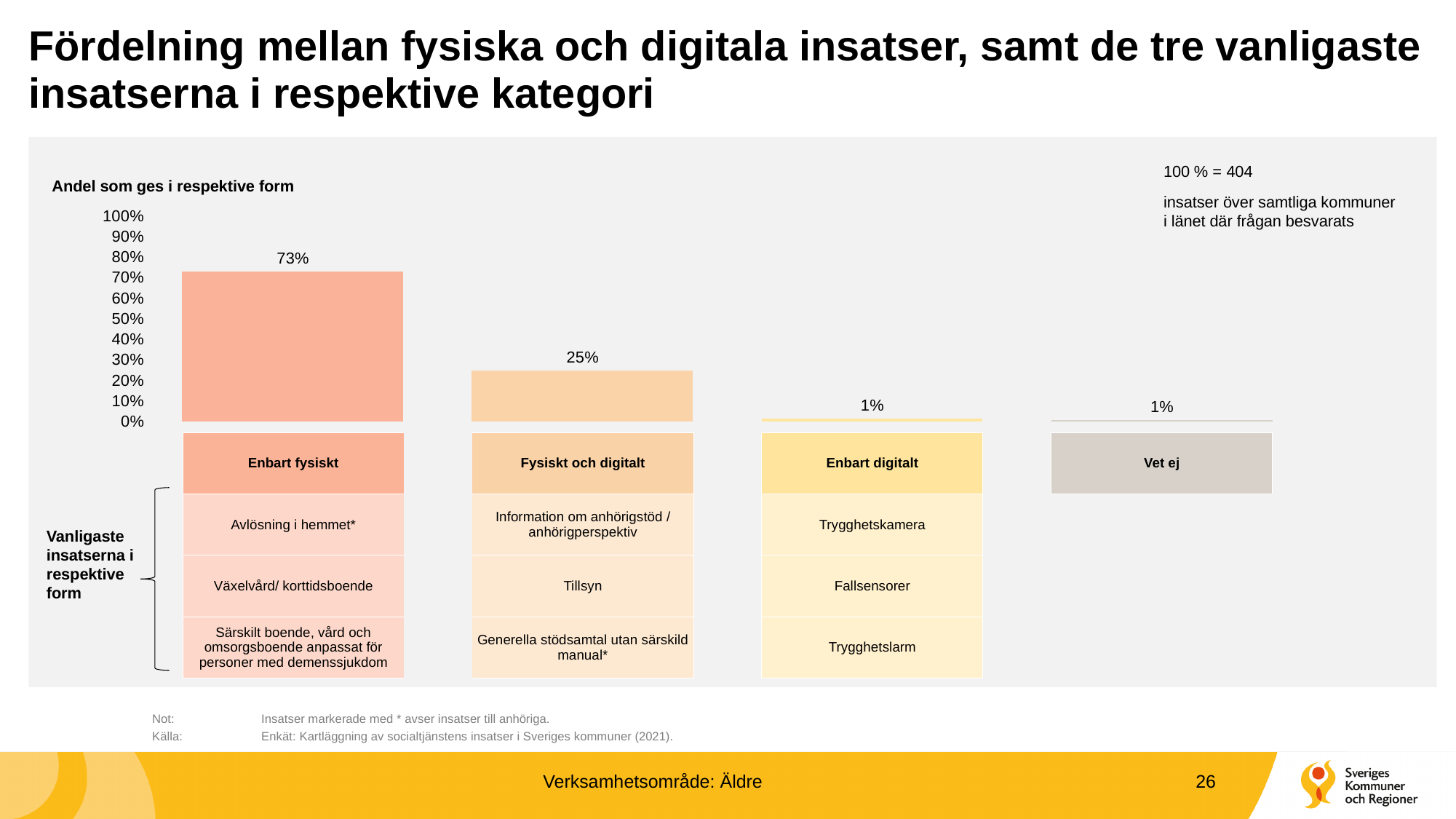
Which category has the highest value? Enbart fysiskt Which is larger, the value for Fysiskt och digitalt or the value for Enbart digitalt? Fysiskt och digitalt Is the value for Enbart fysiskt greater or less than 50%? greater What is the value for Enbart fysiskt? 73% What is the value for Fysiskt och digitalt? 25% What is the difference between the values for Enbart fysiskt and Fysiskt och digitalt? 48% Do the values rise or fall from left to right across the categories? fall What is the value for Enbart digitalt? 1% What is the title of the chart? Andel som ges i respektive form How many categories are shown in the bar chart? 4 What kind of chart is shown on the slide? bar chart What is the value for Vet ej? 1%